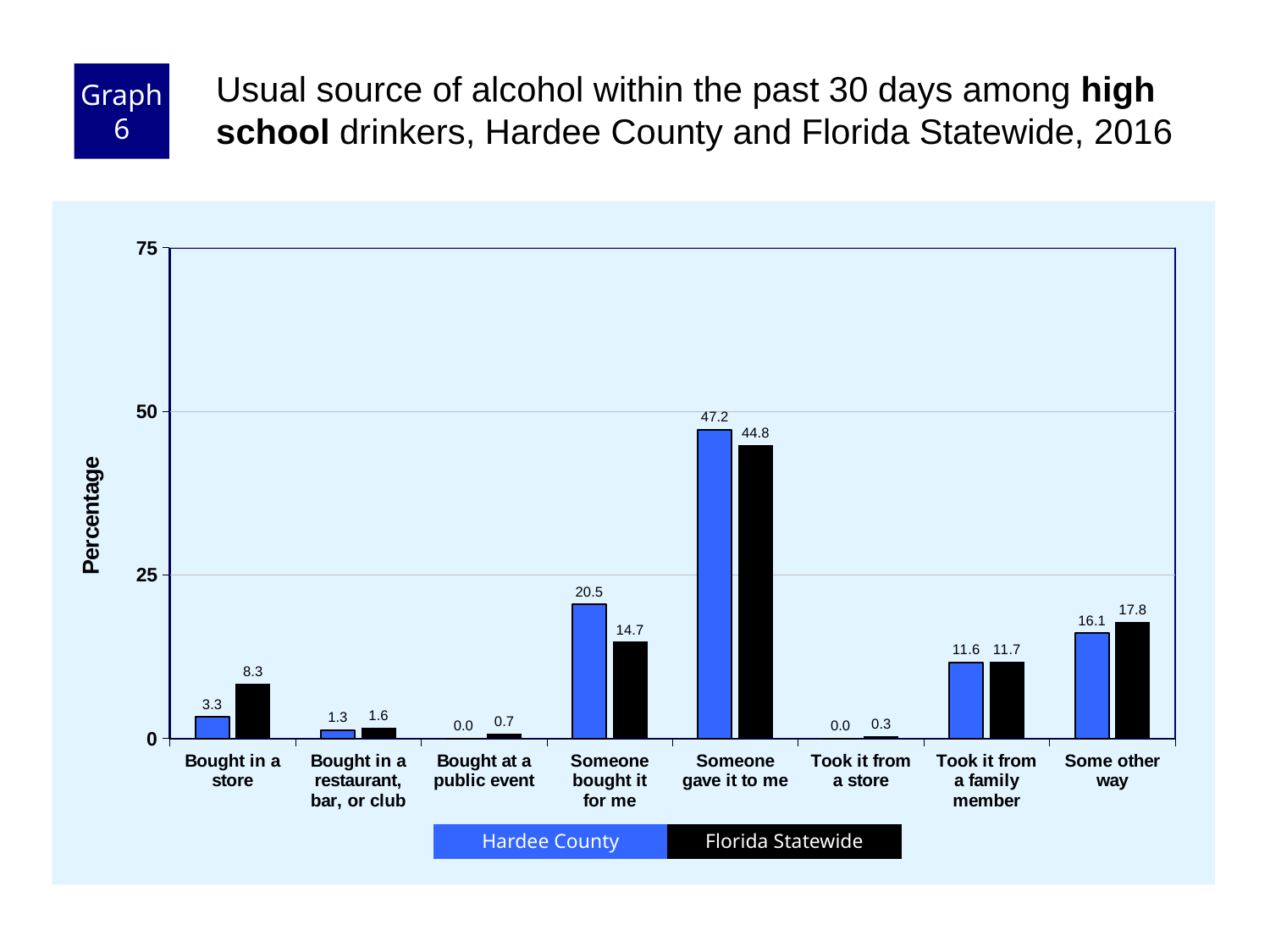
What is the Hardee County value for "Someone gave it to me"? 47.2 Which category has the lowest Florida Statewide value? Took it from a store What kind of chart is shown on the slide? Bar chart What is the difference between the Hardee County and Florida Statewide values for "Someone bought it for me"? 5.8 How many categories are shown on the x axis? 8 Is the Hardee County value for "Someone gave it to me" greater or less than 50? less What is the Florida Statewide value for "Bought in a store"? 8.3 What is the label of the y axis? Percentage Which category has the highest Florida Statewide value? Someone gave it to me Which is larger for "Some other way": Hardee County or Florida Statewide? Florida Statewide How many series does the legend list? 2 What is the Hardee County value for "Someone bought it for me"? 20.5